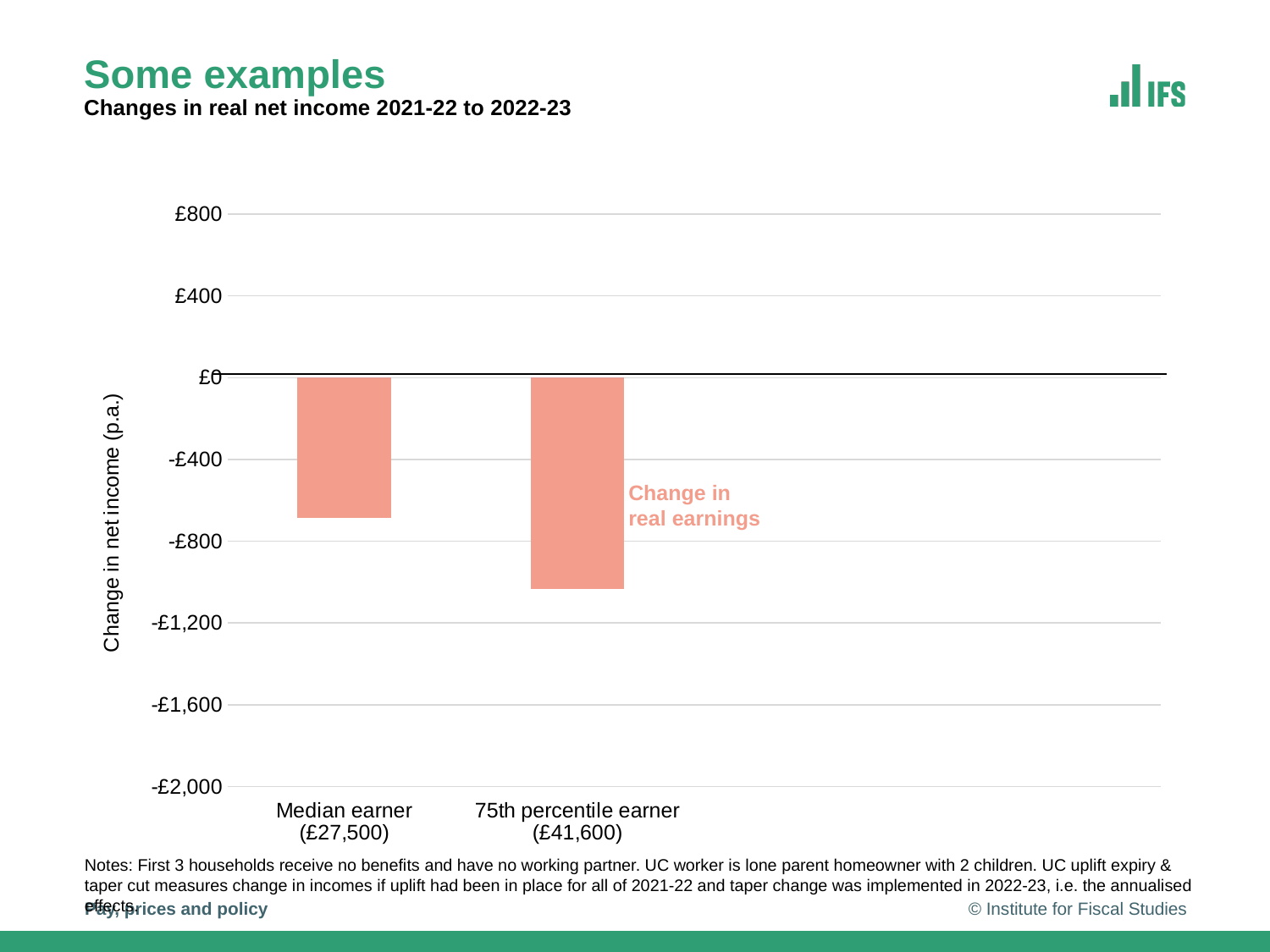
Is the change in net income for the 75th percentile earner greater or less than -£800? less How many categories (bars) are plotted in the chart? 2 What is the label on the vertical axis of the chart? Change in net income (p.a.) Is the change in net income for the 75th percentile earner greater or less than -£1,200? greater What does the text annotation next to the bars say? Change in real earnings Which category has the lowest (most negative) change in net income? 75th percentile earner (£41,600) Is the change in net income for the Median earner greater or less than -£800? greater Do the values rise or fall moving from the Median earner to the 75th percentile earner? fall Which bar is larger in magnitude: Median earner or 75th percentile earner? 75th percentile earner Which category has the higher (less negative) change in net income? Median earner (£27,500) What kind of chart is shown on the slide? bar chart